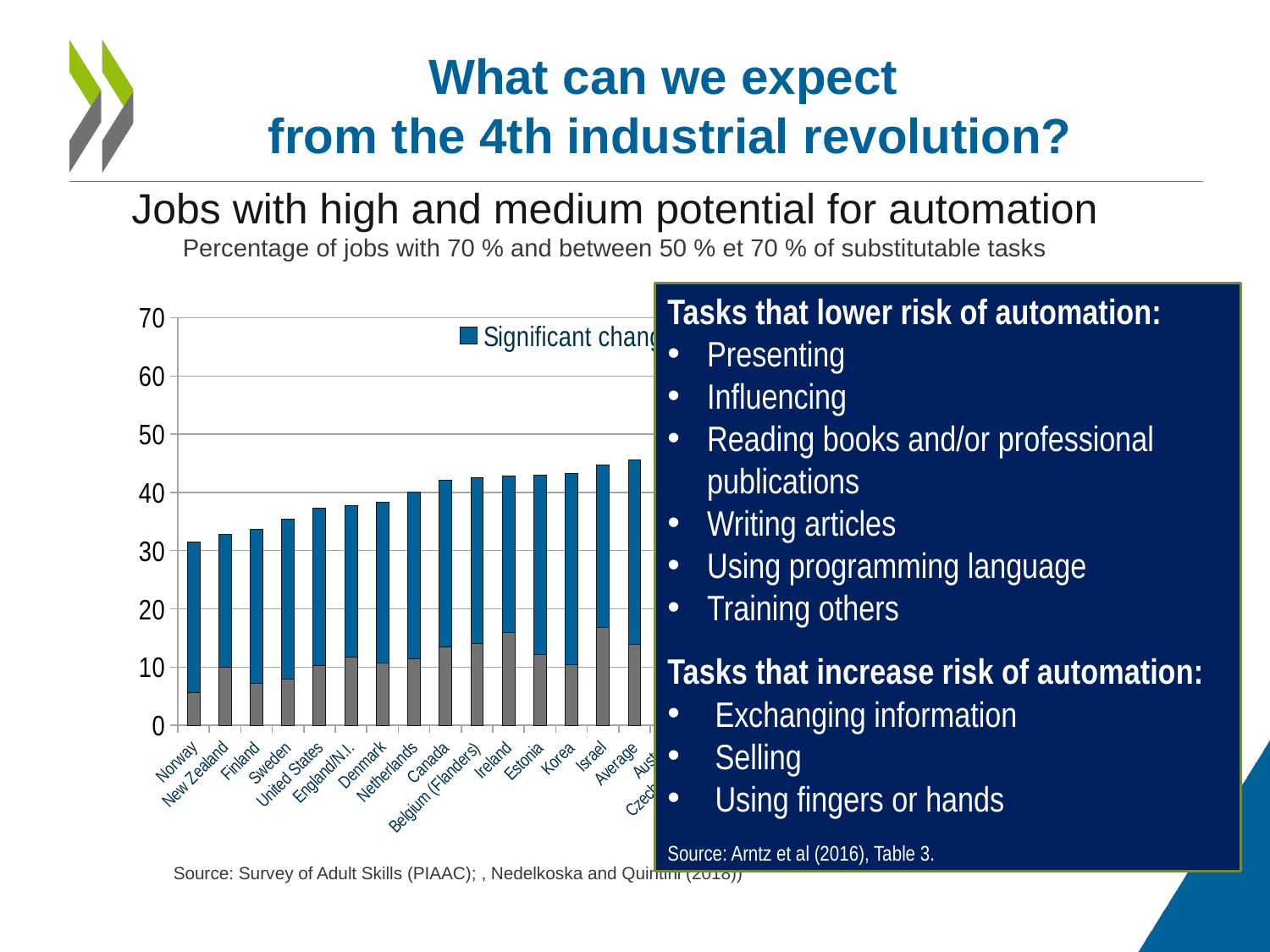
Is the grey (bottom) segment for Ireland greater or less than 10? greater Is the grey (bottom) segment for Israel greater or less than 10? greater Is the total bar height for Israel greater or less than 40? greater What kind of chart is shown on the slide? Stacked bar chart Among the visible countries, which has the lowest total bar? Norway Do the total bar heights rise or fall moving from left to right along the x axis? rise Which has the larger grey (bottom) segment, Norway or Canada? Canada What is the title of the chart on the slide? Jobs with high and medium potential for automation Which has the taller total bar, Norway or Israel? Israel